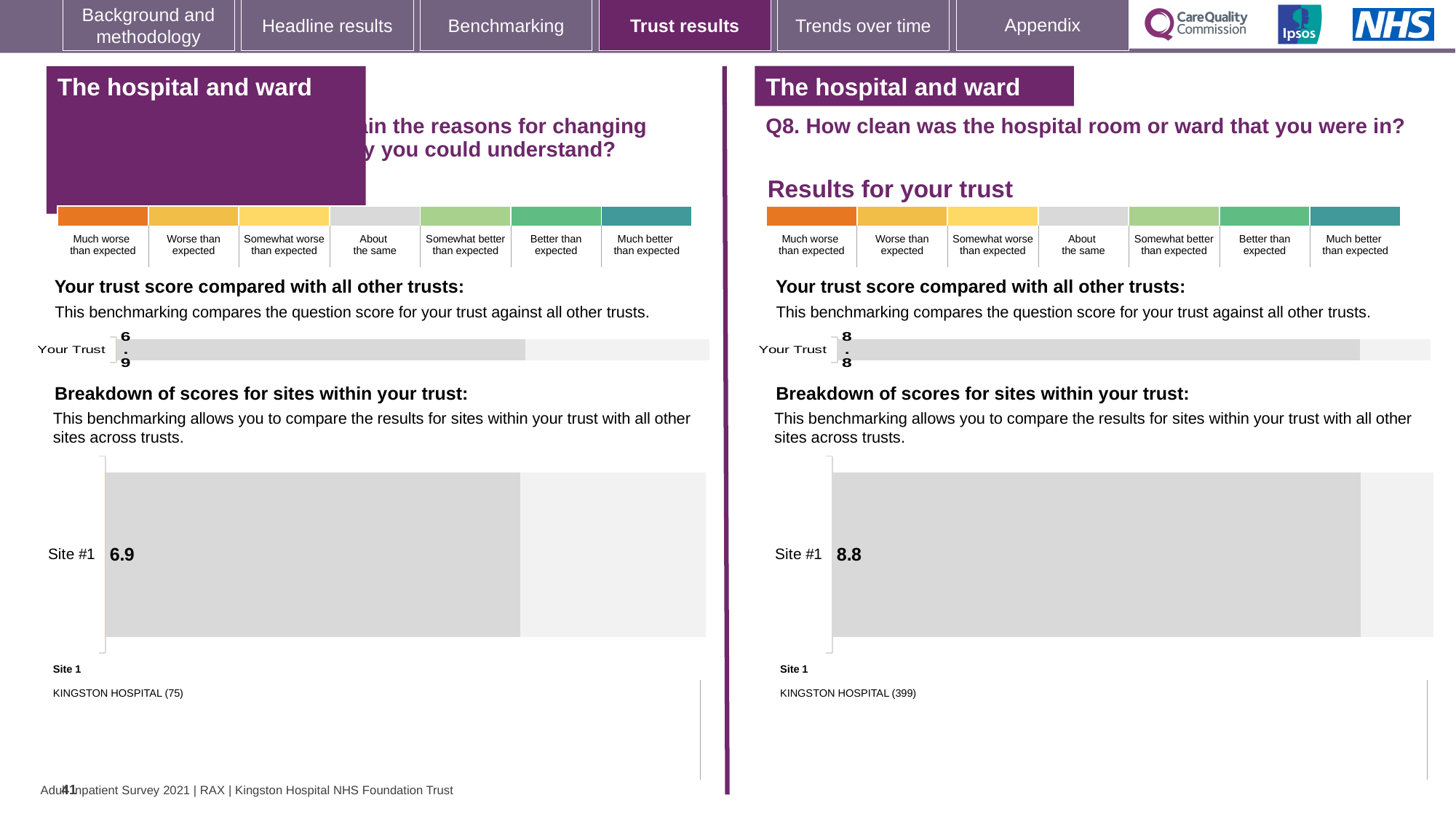
On the left half of the slide, which site is listed as Site 1 below the breakdown chart? KINGSTON HOSPITAL (75) Which is larger: the Site #1 score on the left half of the slide or the Site #1 score on the right half (Q8)? Right half (Q8), 8.8 Is the Your Trust score on the right half of the slide (Q8) greater or less than the Your Trust score on the left half? greater On the left half of the slide, what is the score shown for Your Trust in the trust score comparison chart? 6.9 On the left half of the slide, what score is shown for Site #1 in the breakdown of scores for sites within your trust? 6.9 On the right half of the slide (Q8), what score is shown for Site #1 in the breakdown of scores for sites within your trust? 8.8 What is the difference between the Site #1 score on the right half of the slide (8.8) and the Site #1 score on the left half (6.9)? 1.9 How many sites are shown in the breakdown of scores for sites within your trust on the right half of the slide (Q8)? 1 How many sites are shown in the breakdown of scores for sites within your trust on the left half of the slide? 1 On the right half of the slide (Q8), which site is listed as Site 1 below the breakdown chart? KINGSTON HOSPITAL (399) What kind of chart is used to show the Site #1 score in the breakdown of scores for sites within your trust on the right half of the slide? Bar chart On the right half of the slide (Q8, how clean was the hospital room or ward), what is the score shown for Your Trust? 8.8